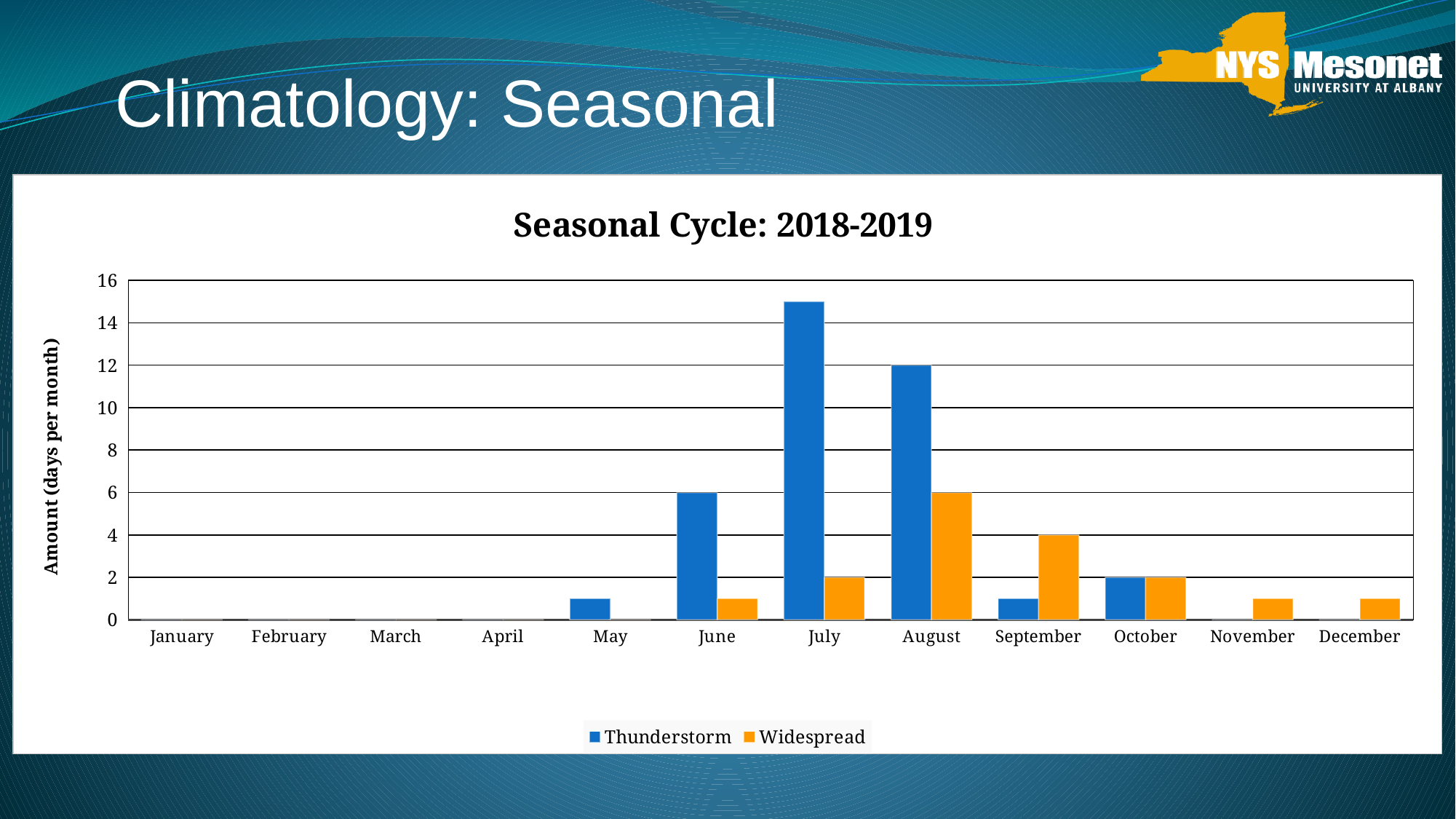
How many series does the legend list? 2 Is the Thunderstorm value for July greater or less than 14? greater What type of chart is shown on the slide? bar chart What is the title of the chart? Seasonal Cycle: 2018-2019 Which is larger in September, the Thunderstorm value or the Widespread value? Widespread Which month has the highest Thunderstorm value? July Which month has the highest Widespread value? August What is the Widespread value for September? 4 What is the difference between the Widespread value for August and the Widespread value for July? 4 What is the Thunderstorm value for August? 12 What is the Thunderstorm value for June? 6 How many months are shown on the x axis? 12